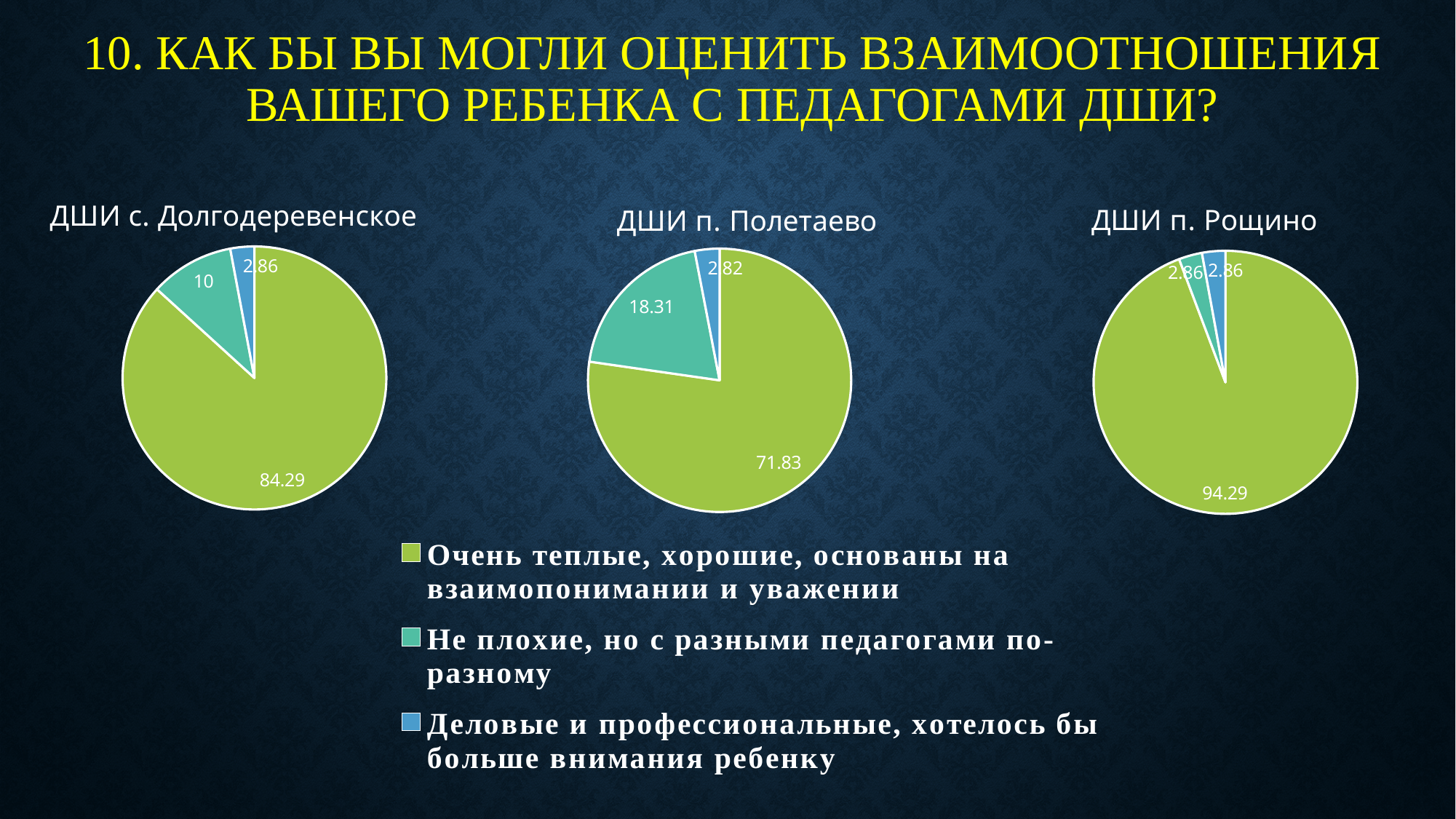
In the chart titled "ДШИ с. Долгодеревенское", what is the value for "Очень теплые, хорошие, основаны на взаимопонимании и уважении"? 84.29 How many entries does the legend list? 3 In the chart titled "ДШИ с. Долгодеревенское", which category has the largest slice? Очень теплые, хорошие, основаны на взаимопонимании и уважении How many pie charts are shown on the slide? 3 What kind of chart is the chart titled "ДШИ п. Полетаево"? Pie chart In the chart titled "ДШИ п. Рощино", what is the value for "Деловые и профессиональные, хотелось бы больше внимания ребенку"? 2.86 In the chart titled "ДШИ п. Полетаево", what is the value for "Не плохие, но с разными педагогами по-разному"? 18.31 In the chart titled "ДШИ п. Полетаево", what is the value for "Деловые и профессиональные, хотелось бы больше внимания ребенку"? 2.82 In the chart titled "ДШИ п. Полетаево", which category has the smallest slice? Деловые и профессиональные, хотелось бы больше внимания ребенку In the chart titled "ДШИ с. Долгодеревенское", what is the difference between the values for "Очень теплые, хорошие, основаны на взаимопонимании и уважении" and "Не плохие, но с разными педагогами по-разному"? 74.29 How many slices does the chart titled "ДШИ п. Рощино" have? 3 Which is larger: the value for "Не плохие, но с разными педагогами по-разному" in the chart titled "ДШИ п. Полетаево" or in the chart titled "ДШИ с. Долгодеревенское"? ДШИ п. Полетаево